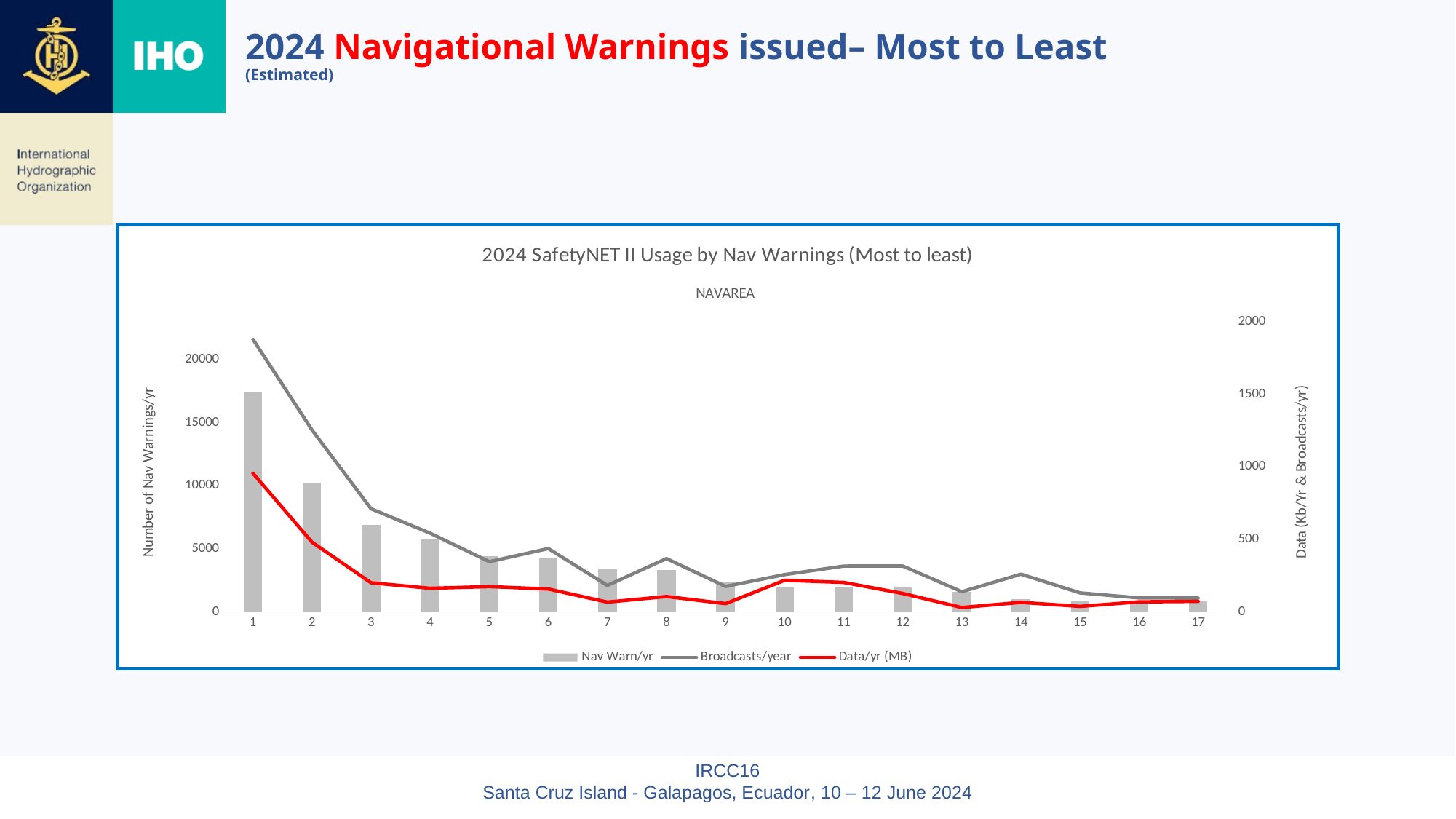
How many NAVAREA categories are shown on the x axis? 17 Which has the larger Nav Warn/yr value, NAVAREA 1 or NAVAREA 2? NAVAREA 1 Is the Broadcasts/year value for NAVAREA 1 greater or less than 1500 on the right axis? greater What kind of chart is shown on the slide? A combined bar and line chart What colour is the Data/yr (MB) line? Red Which NAVAREA has the highest Nav Warn/yr bar? 1 Do the Nav Warn/yr bars generally rise or fall from NAVAREA 1 to NAVAREA 17? Fall Is the Nav Warn/yr value for NAVAREA 1 greater or less than 15000? greater Is the Nav Warn/yr value for NAVAREA 2 greater or less than 15000? less How many series does the legend list? 3 What is the title of the chart? 2024 SafetyNET II Usage by Nav Warnings (Most to least)